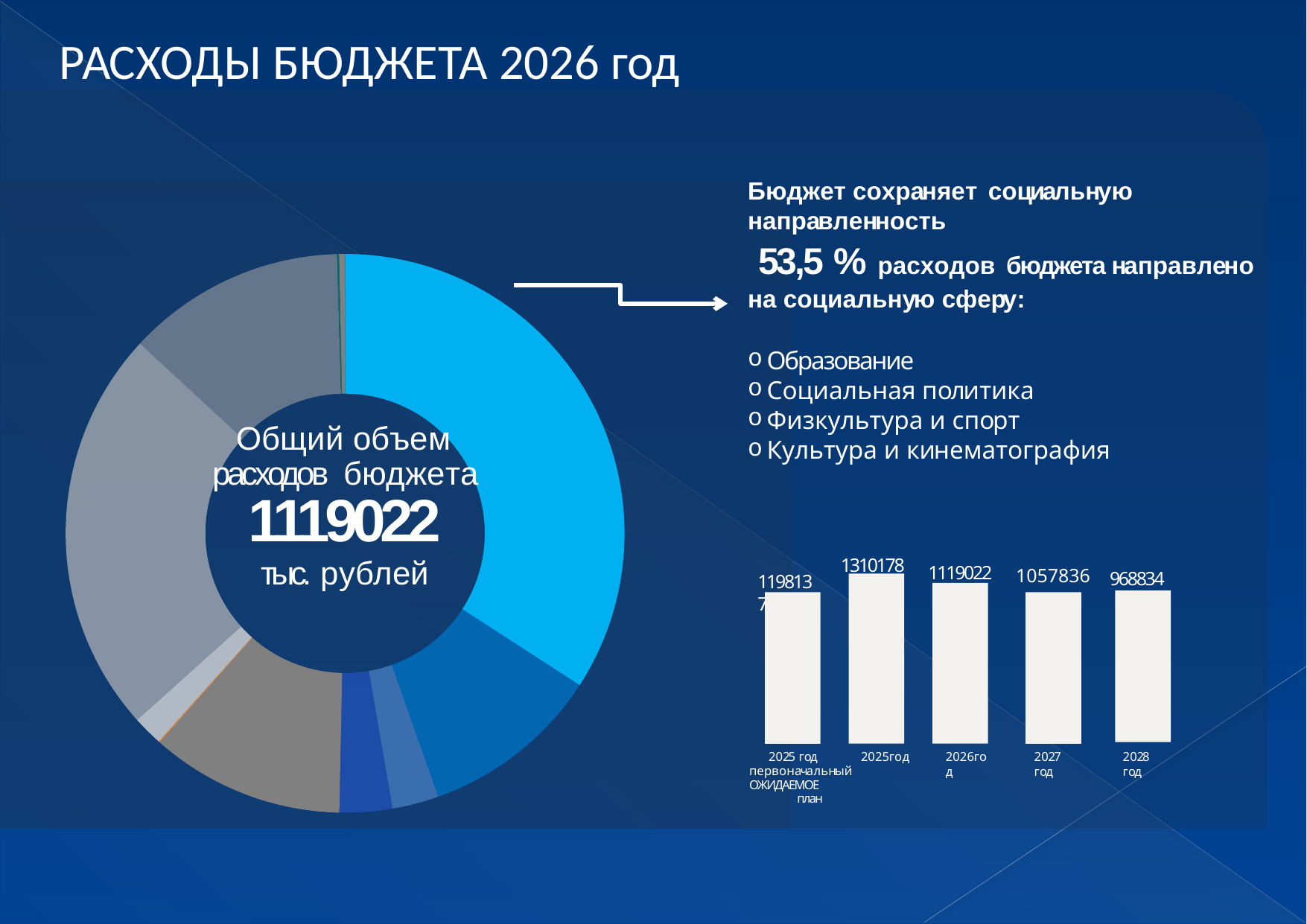
How many bars are in the bar chart on the right? 5 In the bar chart on the right, what is the value for 2025 год ожидаемое? 1310178 In the bar chart on the right, what is the difference between the values for 2025 год ожидаемое and 2026 год? 191156 In the bar chart on the right, do the values rise or fall from 2025 год ожидаемое to 2028 год? Fall What kind of chart is shown on the left side of the slide? Donut (pie) chart In the bar chart on the right, what is the difference between the values for 2026 год and 2027 год? 61186 In the bar chart on the right, which is larger: the value for 2026 год or the value for 2028 год? 2026 год In the bar chart on the right, what is the value for 2026 год? 1119022 In the bar chart on the right, what is the value for 2027 год? 1057836 In the bar chart on the right, which category has the lowest value? 2028 год In the bar chart on the right, which category has the highest value? 2025 год ожидаемое In the bar chart on the right, what is the value for 2028 год? 968834